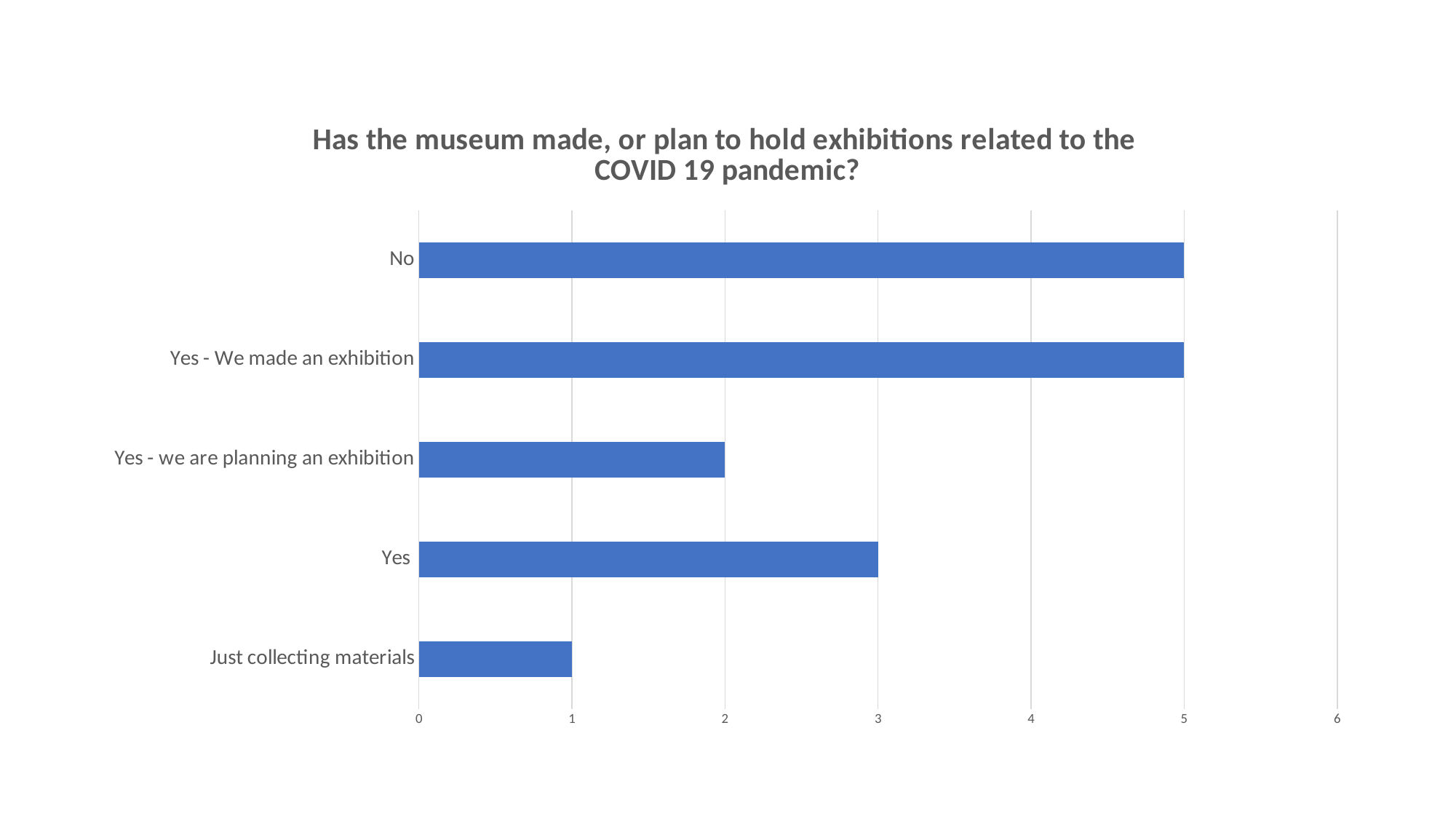
Is the value for "Yes - We made an exhibition" greater or less than 4? greater What kind of chart is shown on the slide? bar chart How many categories are shown in the chart? 5 Which is larger, the value for "Yes" or the value for "Yes - we are planning an exhibition"? Yes What is the title of the chart? Has the museum made, or plan to hold exhibitions related to the COVID 19 pandemic? Which category has the lowest value? Just collecting materials What is the highest value shown on the horizontal axis? 6 What is the value for "Yes"? 3 What is the value for "No"? 5 What is the value for "Just collecting materials"? 1 What is the value for "Yes - we are planning an exhibition"? 2 What is the difference between the values for "No" and "Yes"? 2